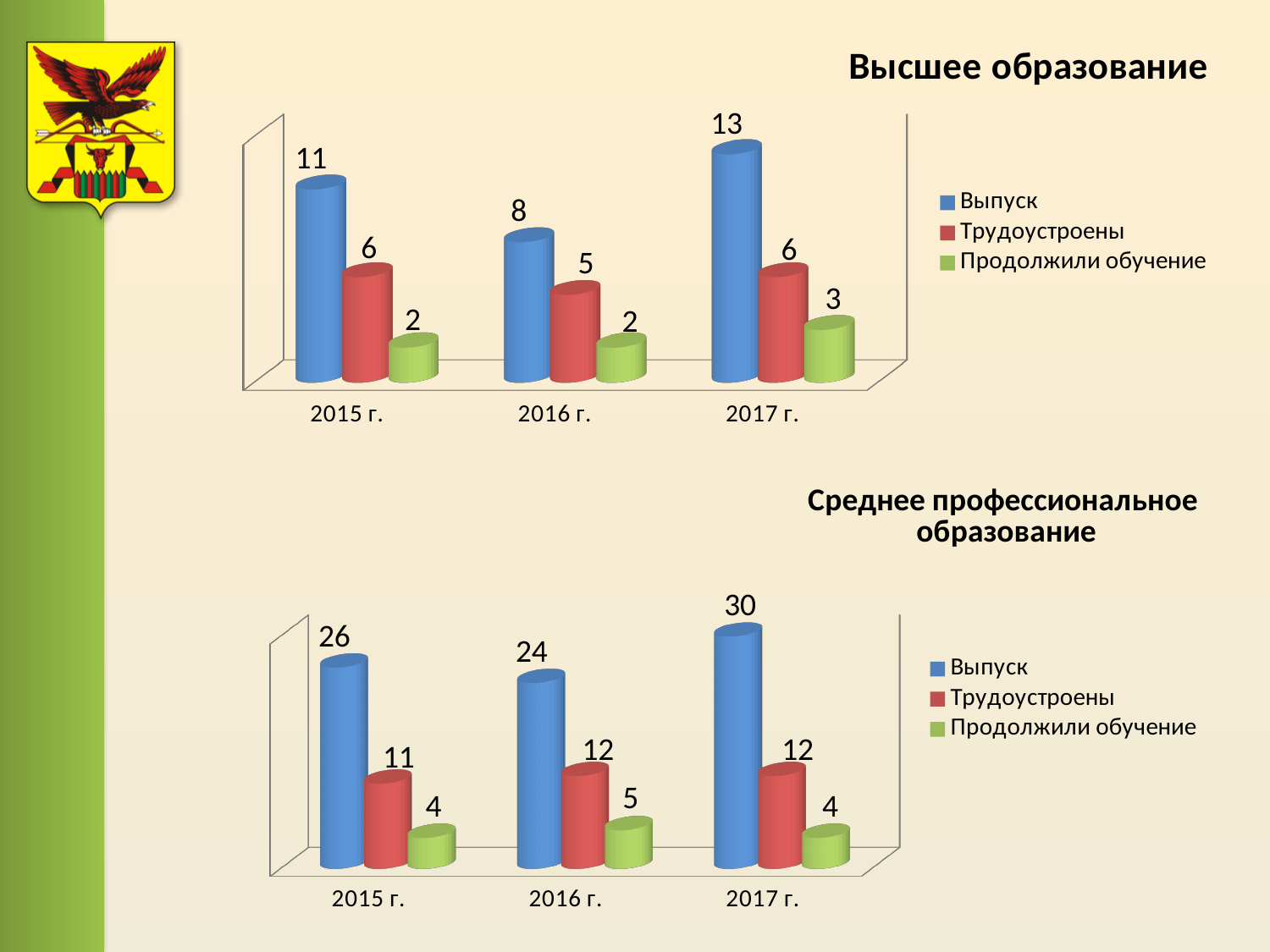
In the 'Среднее профессиональное образование' chart, what is the value of 'Продолжили обучение' for 2016 г.? 5 In the 'Среднее профессиональное образование' chart, is 'Трудоустроены' larger in 2015 г. or 2017 г.? 2017 г. In the 'Высшее образование' chart, what is the value of 'Трудоустроены' for 2016 г.? 5 How many year categories are shown on the x axis of the 'Среднее профессиональное образование' chart? 3 In the 'Высшее образование' chart, what is the value of 'Выпуск' for 2017 г.? 13 What type of chart is the 'Высшее образование' chart? Bar chart In the 'Среднее профессиональное образование' chart, what is the difference between 'Выпуск' in 2017 г. and 2015 г.? 4 In the 'Среднее профессиональное образование' chart, what is the value of 'Выпуск' for 2016 г.? 24 In the 'Высшее образование' chart, how many series does the legend list? 3 In the 'Высшее образование' chart, what is the difference between 'Выпуск' and 'Трудоустроены' in 2015 г.? 5 In the 'Высшее образование' chart, which year has the highest 'Выпуск' value? 2017 г. In the 'Среднее профессиональное образование' chart, which year has the lowest 'Выпуск' value? 2016 г.